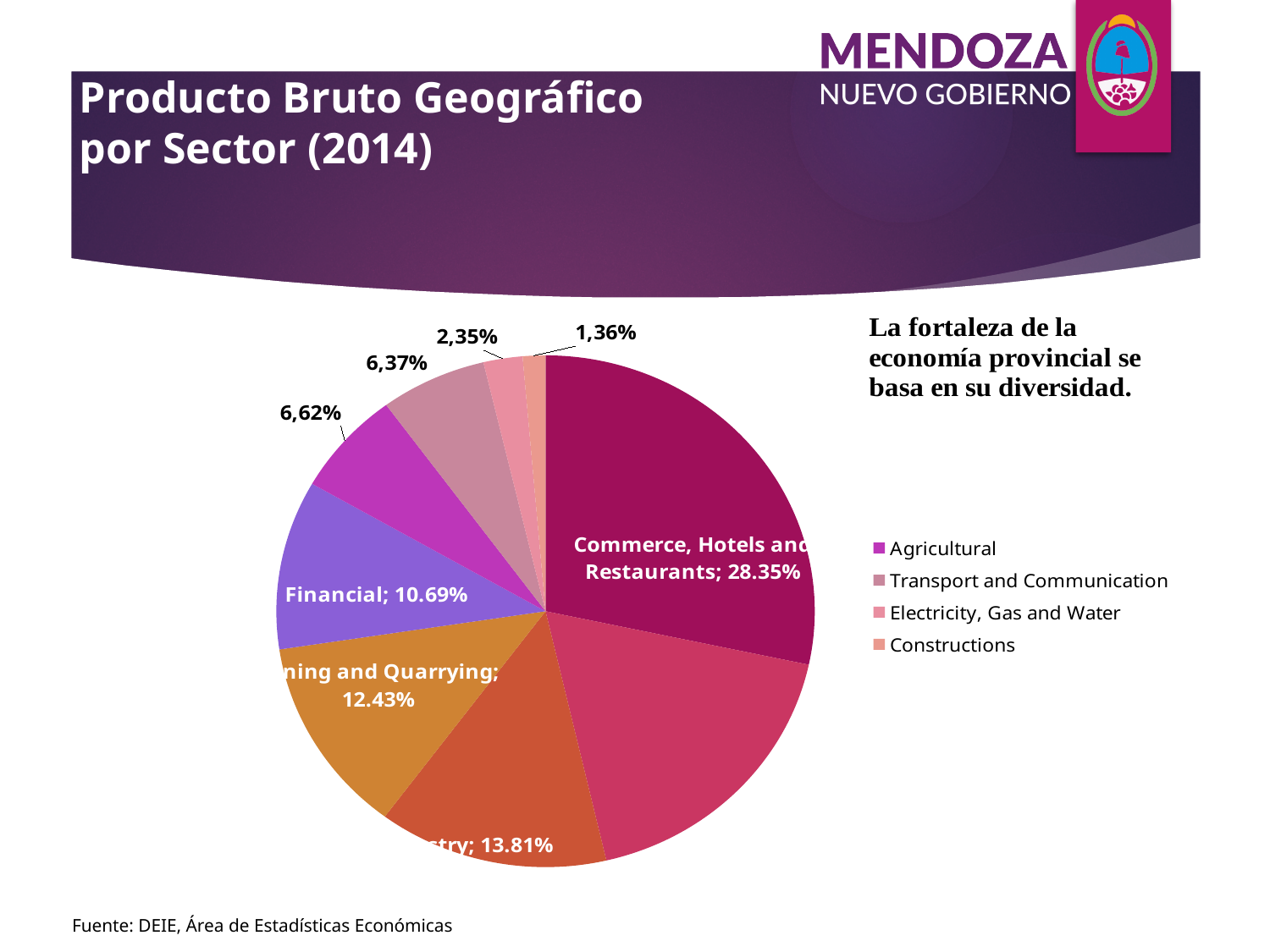
Which sector has the largest slice of the pie? Commerce, Hotels and Restaurants How many slices does the pie chart have? 9 What is the value shown for Financial? 10.69% How many entries does the legend list? 4 What is the difference between the Mining and Quarrying share and the Financial share? 1.74% Which is larger, the Financial slice or the Mining and Quarrying slice? Mining and Quarrying What kind of chart is shown on the slide? pie chart What is the difference between the Commerce, Hotels and Restaurants share and the Financial share? 17.66% What is the smallest percentage labelled on the pie chart? 1,36% What is the value of the Agricultural slice (the magenta slice in the legend)? 6,62% Which year does the slide title say the data refers to? 2014 What share of the pie does Commerce, Hotels and Restaurants hold? 28.35%